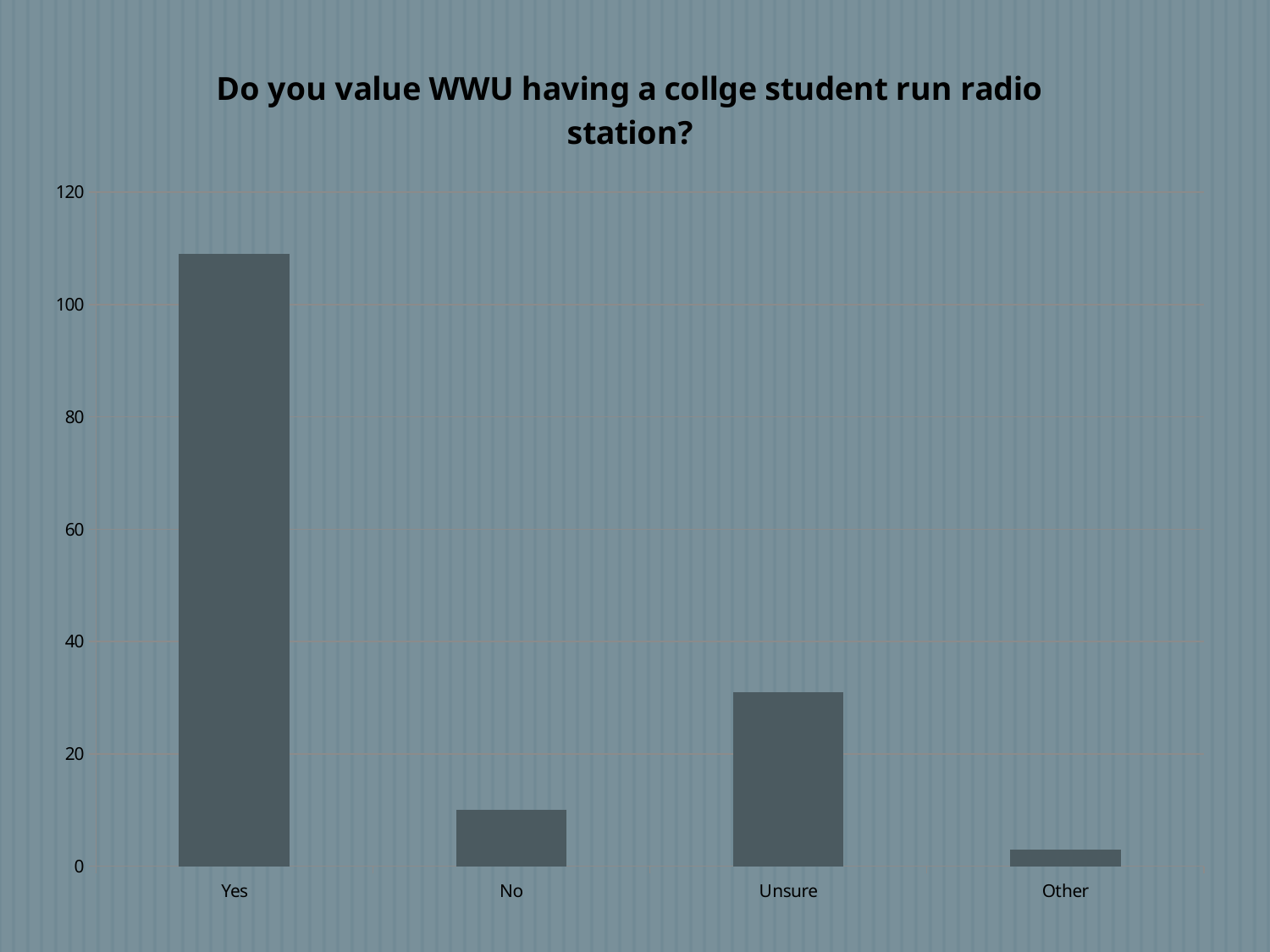
Which category has the highest value? Yes What is the title of the chart? Do you value WWU having a collge student run radio station? How many categories are shown on the x axis? 4 Which has a larger value, Unsure or No? Unsure Is the value for No greater or less than 20? less Is the value for Unsure greater or less than 20? greater Is the value for Yes greater or less than 100? greater Which category has the lowest value? Other Which has a larger value, No or Other? No What kind of chart is shown on the slide? bar chart